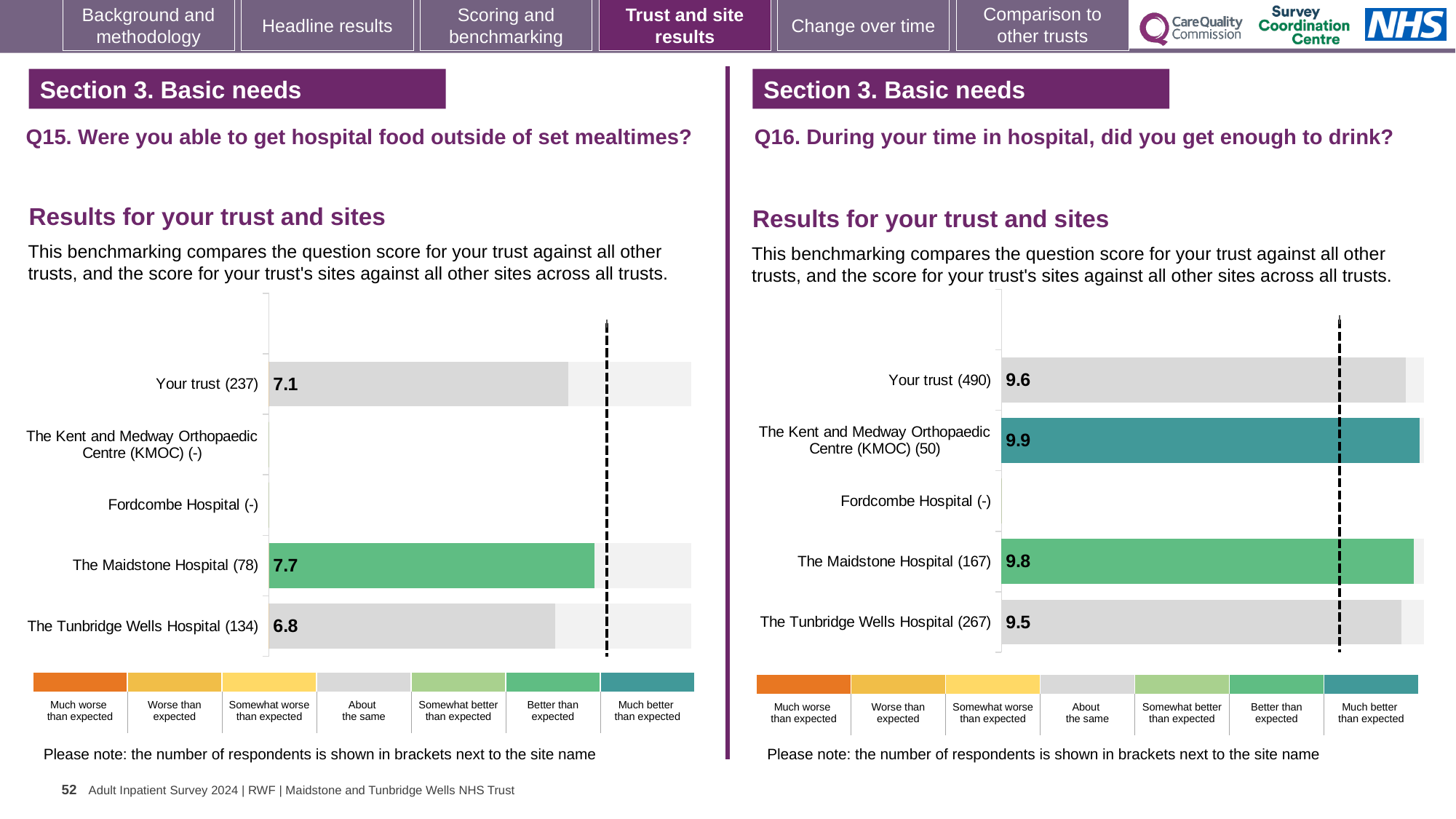
In the Q16 chart (right), which is larger: the score for Your trust or the score for The Maidstone Hospital? The Maidstone Hospital In the Q16 chart (right), what is the score for The Kent and Medway Orthopaedic Centre (KMOC) (50)? 9.9 In the Q16 chart (right), which site has the lowest score? The Tunbridge Wells Hospital (267) In the Q15 chart (left), what is the score for Your trust (237)? 7.1 In the Q15 chart (left), what is the score for The Maidstone Hospital (78)? 7.7 In the Q15 chart (left), what is the difference between the scores for The Maidstone Hospital and The Tunbridge Wells Hospital? 0.9 In the Q15 chart (left), what is the score for The Tunbridge Wells Hospital (134)? 6.8 In the Q16 chart (right), what is the score for The Tunbridge Wells Hospital (267)? 9.5 How many categories (rows) are listed in the Q16 chart on the right? 5 What kind of chart is used for the Q15 results on the left? Bar chart In the Q15 chart (left), which site has the highest score? The Maidstone Hospital (78) In the Q16 chart (right), what is the difference between the scores for The Kent and Medway Orthopaedic Centre (KMOC) and Your trust? 0.3